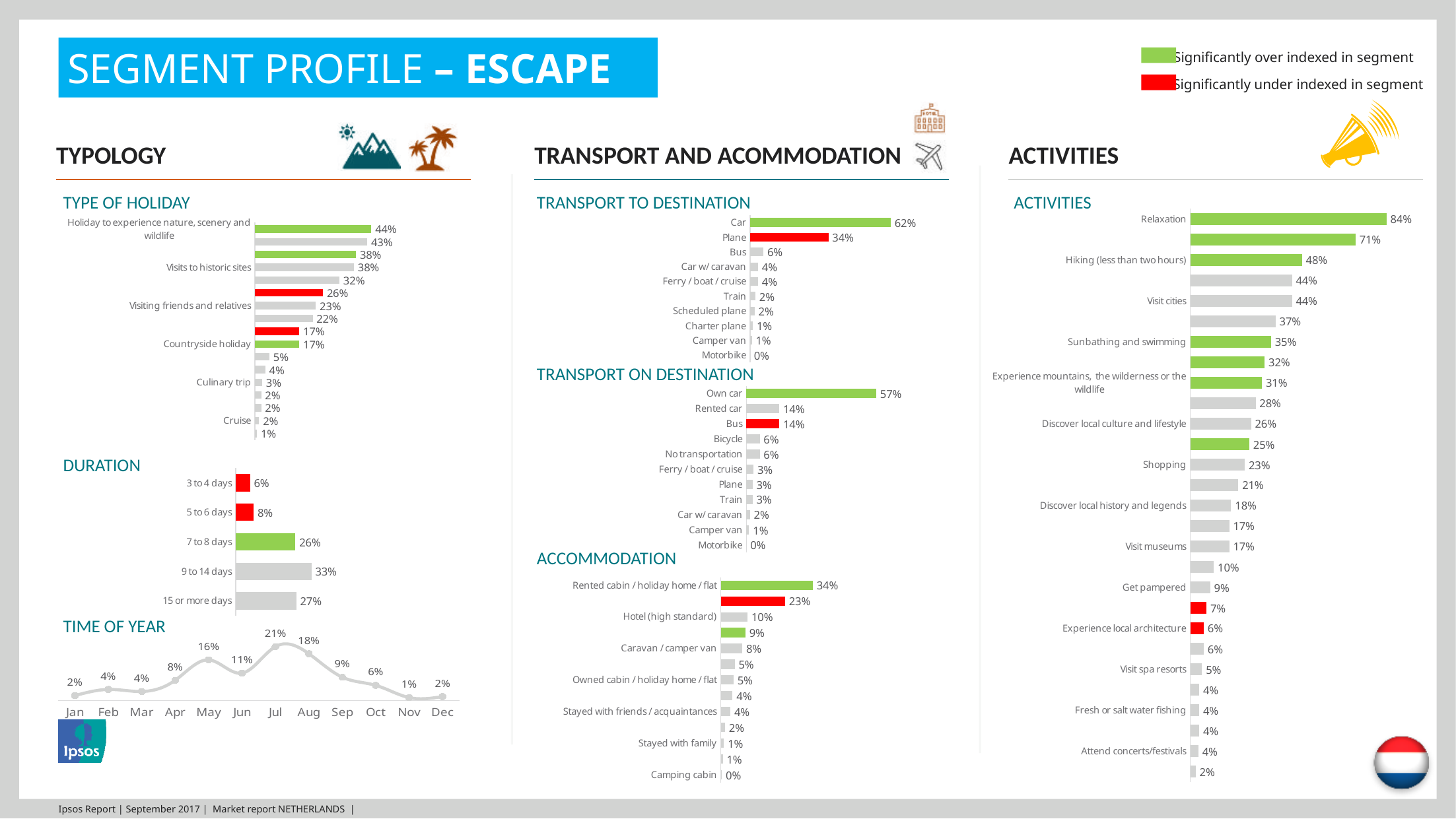
In the ACCOMMODATION chart, what is the value for Hotel (high standard)? 10% In the ACTIVITIES chart, which is larger: Visit cities or Sunbathing and swimming? Visit cities In the ACTIVITIES chart, what is the value for Relaxation? 84% In the TRANSPORT TO DESTINATION chart, what is the value for Plane? 34% In the TRANSPORT ON DESTINATION chart, what is the difference between Own car and Rented car? 43% In the DURATION chart, which duration has the lowest value? 3 to 4 days What kind of chart is the TIME OF YEAR chart? Line chart In the TIME OF YEAR chart, what is the difference between the values for Jul and Aug? 3% In the DURATION chart, what is the value for 9 to 14 days? 33% In the TIME OF YEAR chart, what is the value for May? 16% In the TIME OF YEAR chart, which month has the highest value? Jul In the TRANSPORT TO DESTINATION chart, how many categories are shown? 10